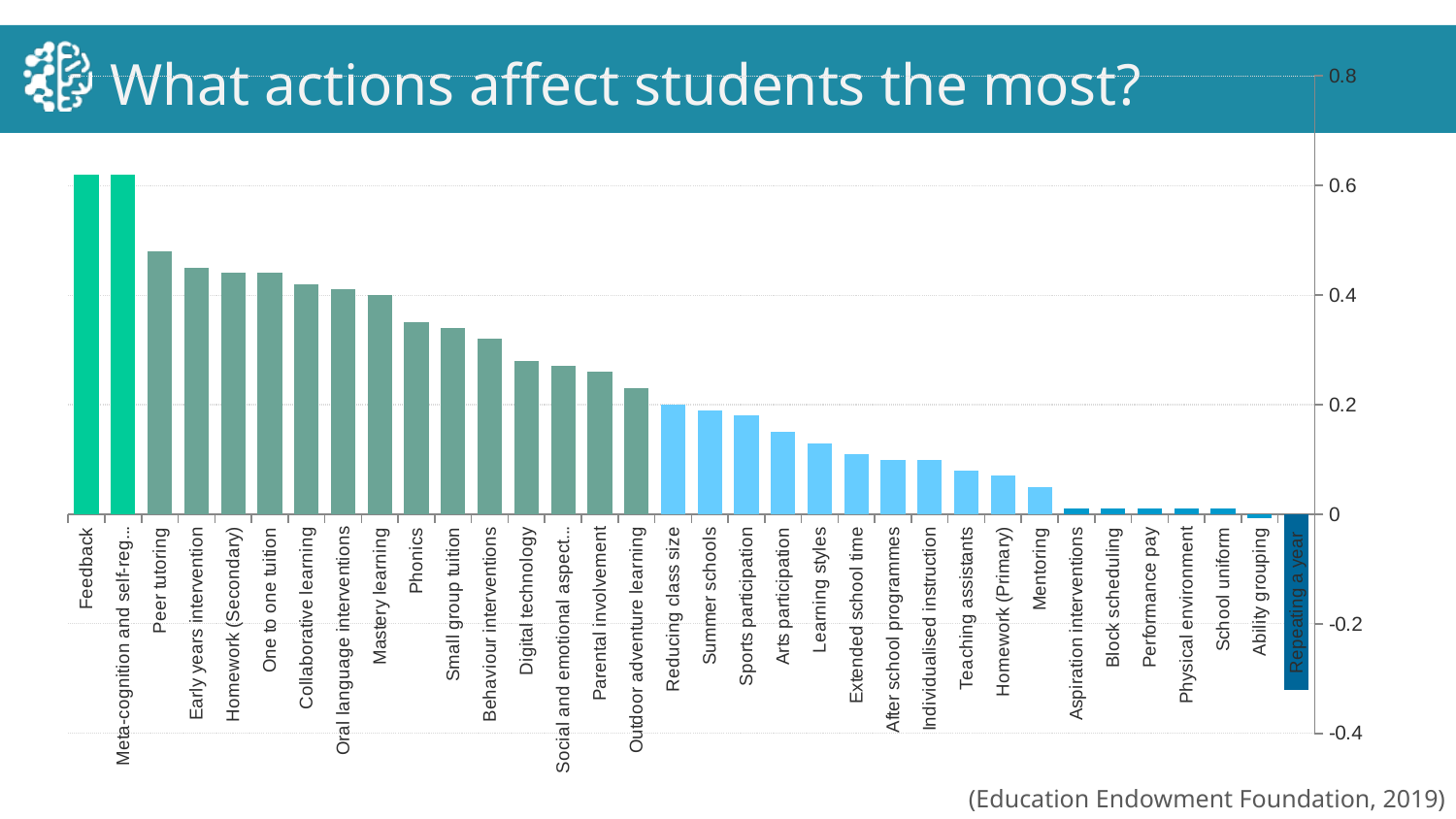
Which has the larger value, Summer schools or Mentoring? Summer schools Do the values generally rise or fall moving from left to right along the x axis? fall How many actions (categories) are plotted in the chart? 34 What is the title of the chart? What actions affect students the most? Which has the larger value, Peer tutoring or Phonics? Peer tutoring Is the value for Peer tutoring greater or less than 0.4? greater Is the value for Repeating a year greater or less than -0.2? less Is the value for Mentoring greater or less than 0.2? less What kind of chart is shown on the slide? bar chart Which action has the lowest value in the chart? Repeating a year